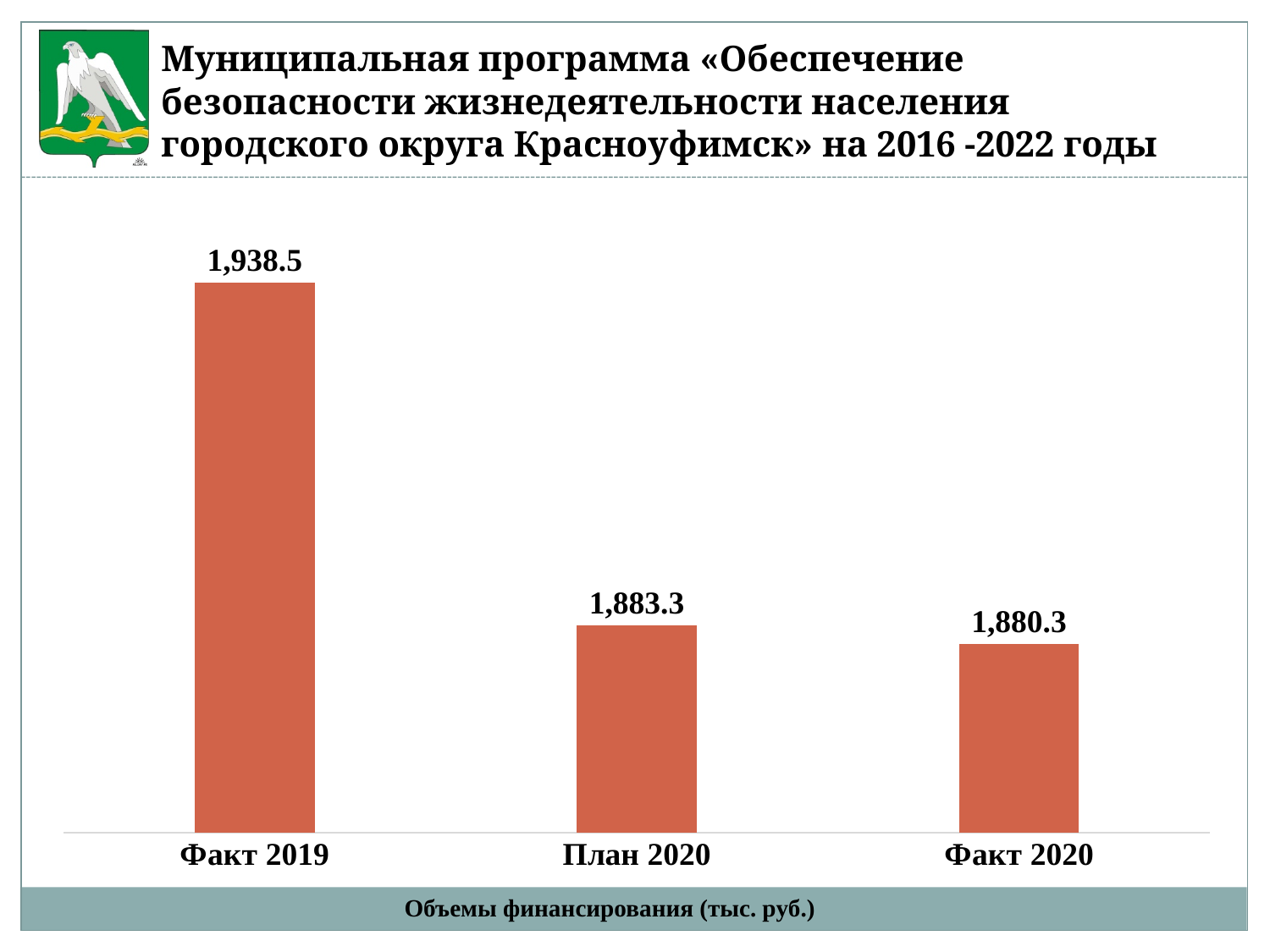
What kind of chart is shown on the slide? Bar chart Do the values rise or fall from left to right across the categories? Fall What is the value for План 2020? 1,883.3 What is the value for Факт 2020? 1,880.3 How many categories are shown in the chart? 3 What is the difference between the values for Факт 2019 and Факт 2020? 58.2 Which category has the highest value? Факт 2019 What is the difference between the values for План 2020 and Факт 2020? 3.0 What is the value for Факт 2019? 1,938.5 Which category has the lowest value? Факт 2020 What is the difference between the values for Факт 2019 and План 2020? 55.2 Which is larger, the value for Факт 2019 or the value for План 2020? Факт 2019